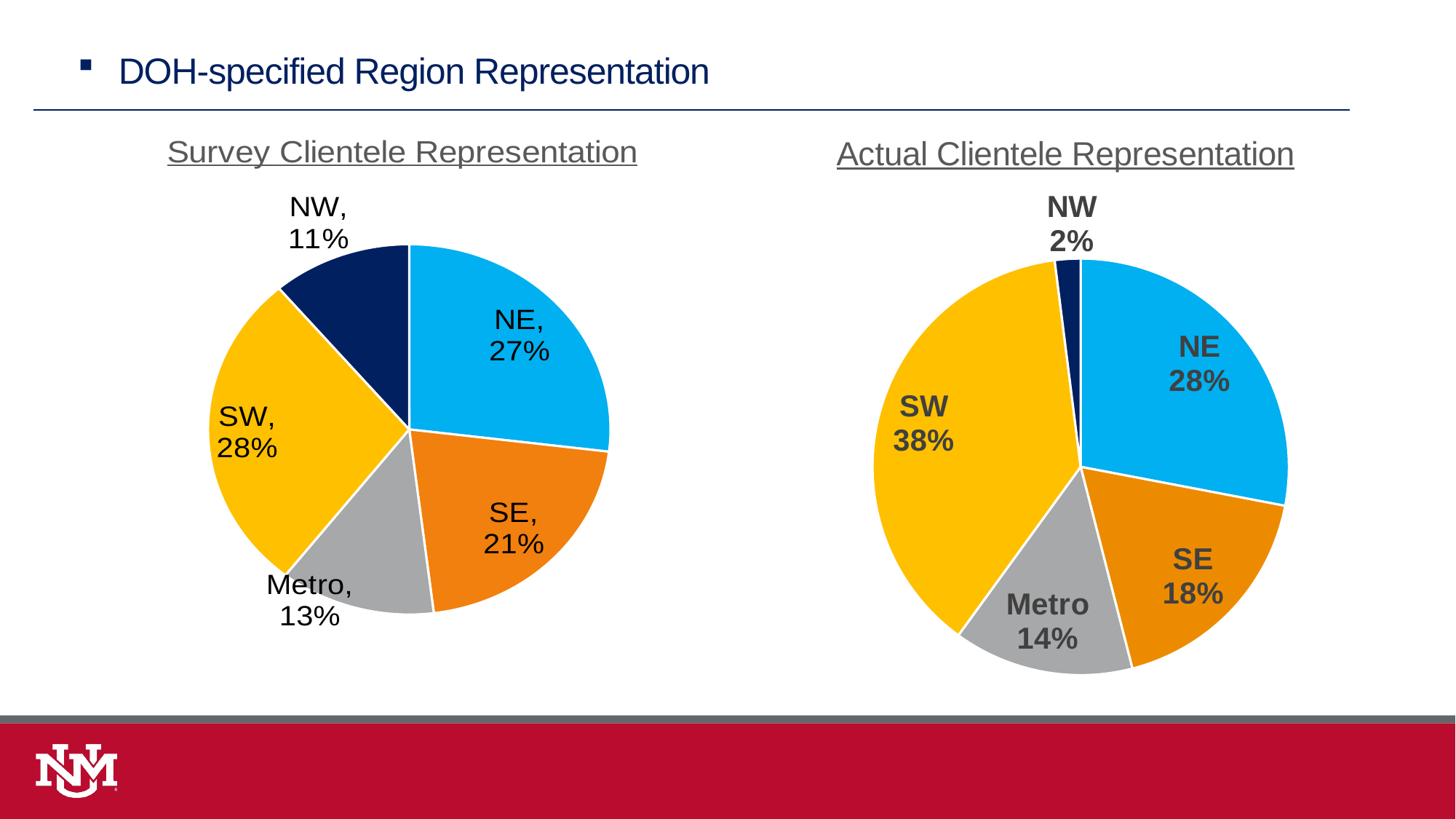
How many slices does the Actual Clientele Representation pie chart have? 5 In the Actual Clientele Representation chart, what is the difference between the SW and NE shares? 10% What colour is the SW slice in the Actual Clientele Representation chart? Yellow In the Survey Clientele Representation chart, what share does NE have? 27% What type of chart is the Survey Clientele Representation chart? Pie chart In the Survey Clientele Representation chart, which is larger, SE or Metro? SE In the Survey Clientele Representation chart, which region has the smallest slice? NW In the Survey Clientele Representation chart, what share does Metro have? 13% In the Actual Clientele Representation chart, what share does NW have? 2% In the Actual Clientele Representation chart, what share does SW have? 38% What is the difference between the NW share in the Survey Clientele Representation chart and the NW share in the Actual Clientele Representation chart? 9% In the Actual Clientele Representation chart, which region has the largest slice? SW